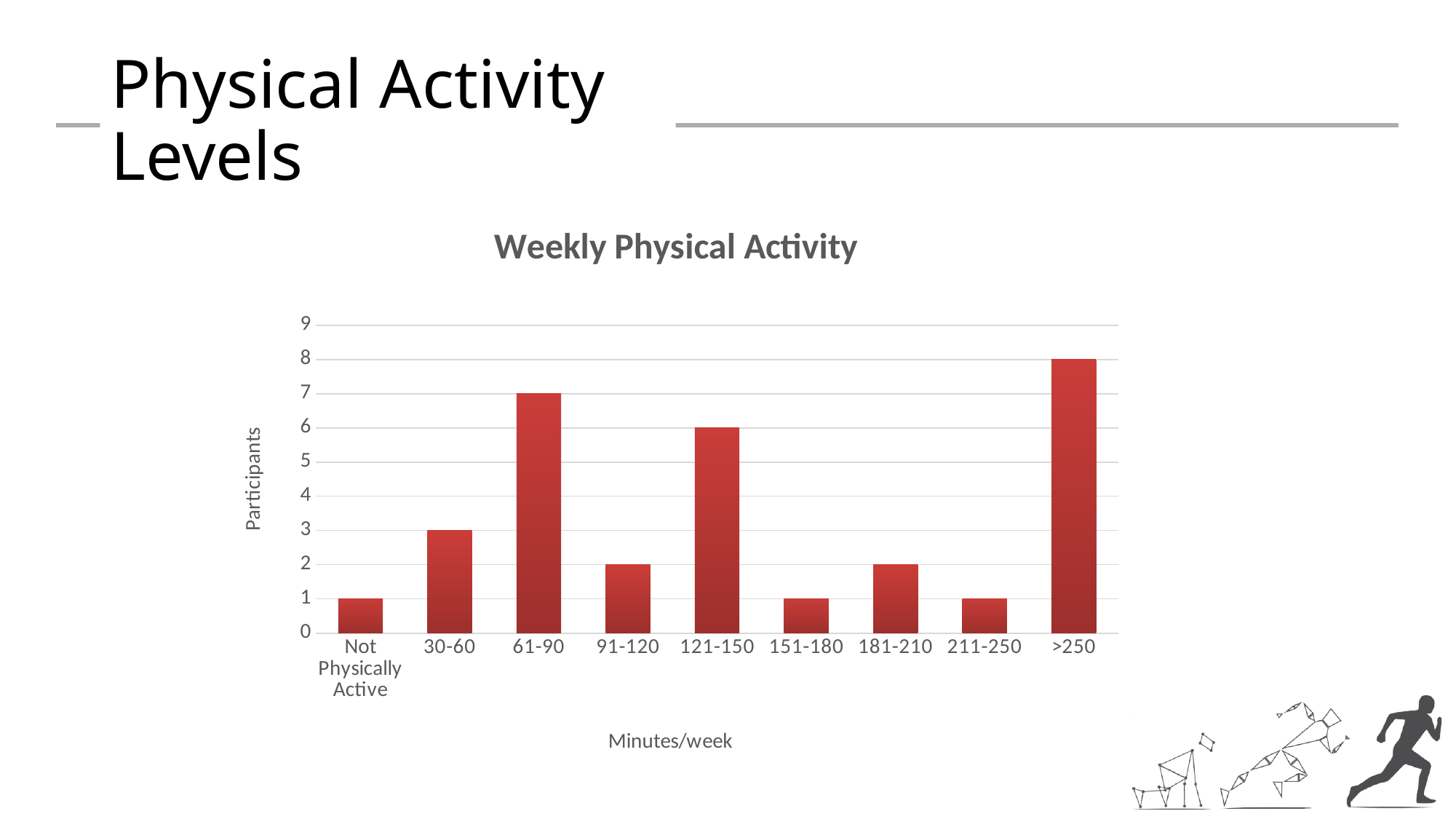
Which category has the highest number of participants? >250 What is the difference in participants between the >250 and 61-90 categories? 1 How many participants are in the 61-90 minutes/week category? 7 What is the label of the y axis? Participants What is the difference in participants between the 121-150 and 30-60 categories? 3 How many participants are in the 30-60 minutes/week category? 3 How many categories are shown on the x axis of the chart? 9 How many participants are in the >250 minutes/week category? 8 What is the title of the chart? Weekly Physical Activity Which has more participants, 91-120 or 121-150? 121-150 How many participants are in the 121-150 minutes/week category? 6 What type of chart is shown on the slide? bar chart